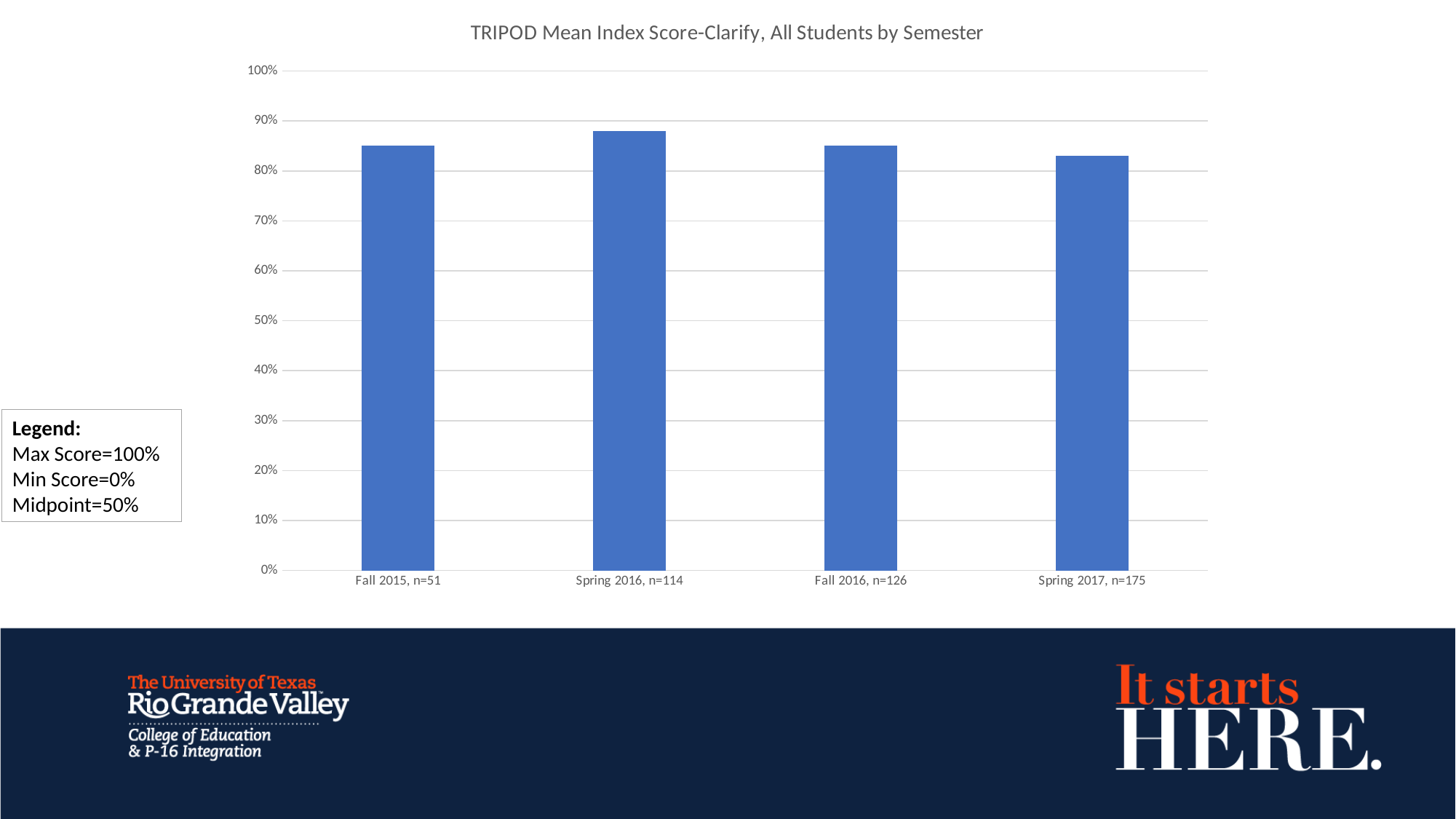
Is the value for Spring 2017, n=175 greater or less than 80%? greater Which semester has the highest mean index score? Spring 2016, n=114 Is the value for Fall 2016, n=126 greater or less than 90%? less What is the title of the chart? TRIPOD Mean Index Score-Clarify, All Students by Semester What is the maximum value shown on the vertical axis? 100% Is the value for Spring 2016, n=114 greater or less than 90%? less What kind of chart is shown on the slide? bar chart What is the sample size (n) shown for Fall 2016? 126 How many semesters (bars) are plotted in the chart? 4 Which is larger, the value for Spring 2016, n=114 or the value for Spring 2017, n=175? Spring 2016, n=114